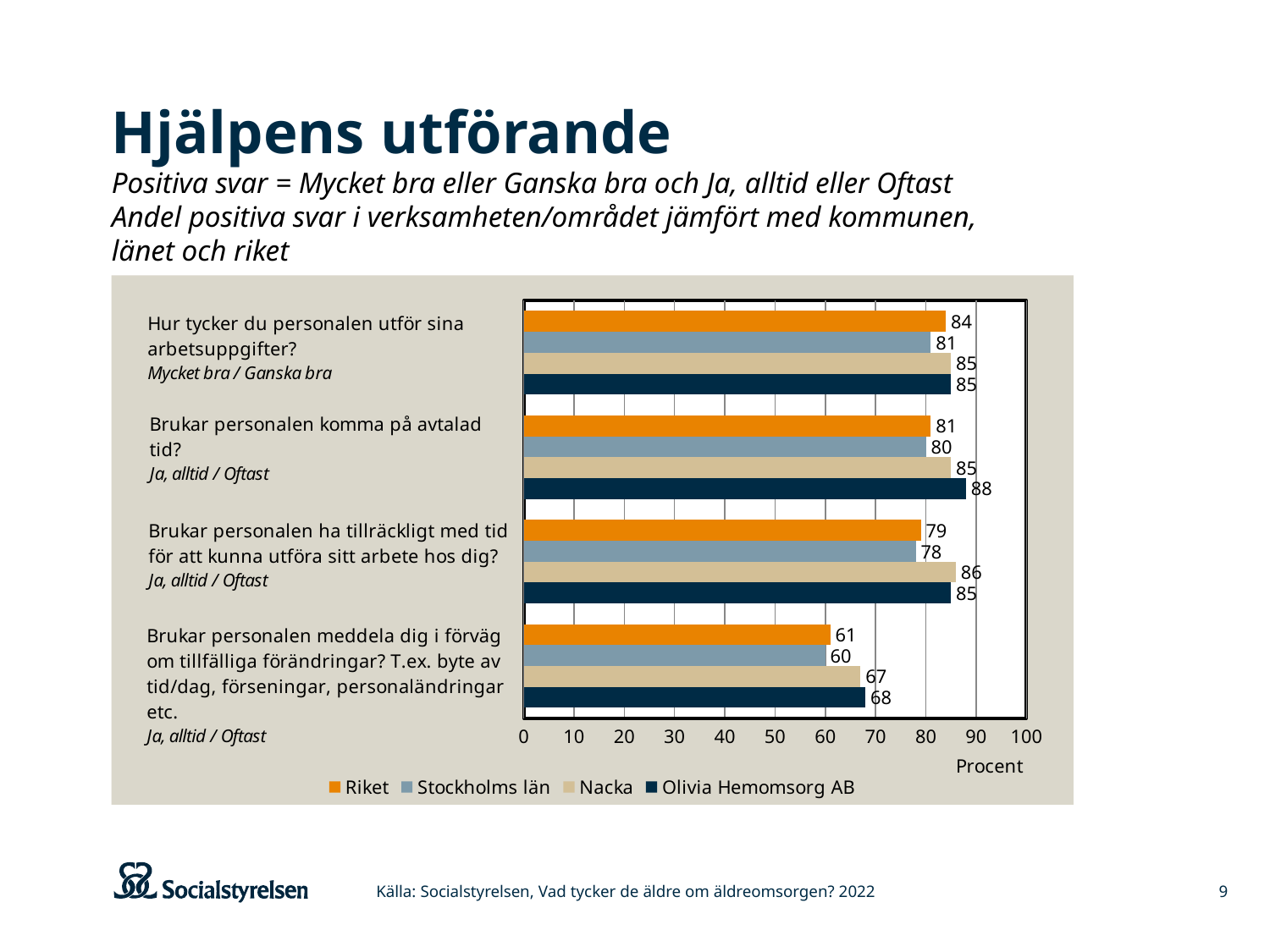
What value is shown for Riket on the question "Hur tycker du personalen utför sina arbetsuppgifter?"? 84 On the question "Brukar personalen ha tillräckligt med tid för att kunna utföra sitt arbete hos dig?", which is larger: the value for Nacka or the value for Riket? Nacka What value is shown for Olivia Hemomsorg AB on the question "Brukar personalen komma på avtalad tid?"? 88 How many questions (categories) are shown on the chart? 4 What value is shown for Stockholms län on the question "Brukar personalen meddela dig i förväg om tillfälliga förändringar?"? 60 What is the difference between the Olivia Hemomsorg AB value and the Riket value on the question "Brukar personalen komma på avtalad tid?"? 7 What kind of chart is shown on the slide? Bar chart What value is shown for Nacka on the question "Brukar personalen ha tillräckligt med tid för att kunna utföra sitt arbete hos dig?"? 86 Which series has the lowest value on the question "Brukar personalen meddela dig i förväg om tillfälliga förändringar?"? Stockholms län What is the label of the horizontal axis? Procent How many series does the legend list? 4 Which series has the highest value on the question "Brukar personalen komma på avtalad tid?"? Olivia Hemomsorg AB